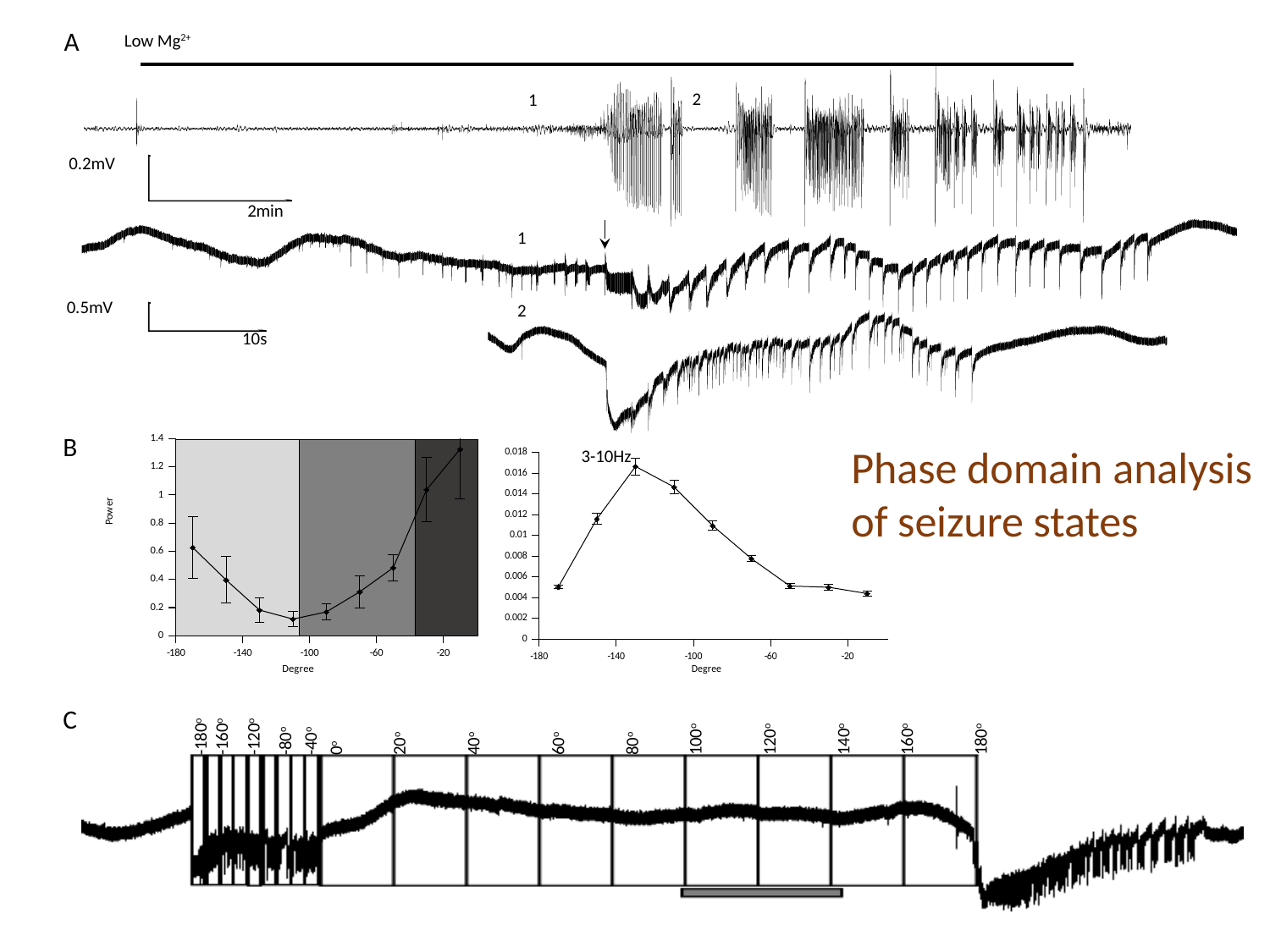
In panel B, on the left (Power) chart, is the lowest point greater or less than 0.2? less In panel B, on the right (3-10Hz) chart, is the highest point greater or less than 0.014? greater In panel B, on the right (3-10Hz) chart, do the values rise or fall from the peak toward the right end of the x axis? fall In panel B, on the left (Power) chart, is the value of the leftmost point greater or less than 0.4? greater In panel B, what kind of chart is the left chart with the y-axis labelled Power? line chart In panel B, on the left (Power) chart, which point is higher: the leftmost point or the rightmost point? the rightmost point In panel B, what label appears at the top of the right chart? 3-10Hz In panel B, how many data points are plotted on the left (Power) chart? 9 In panel B, how many data points are plotted on the right (3-10Hz) chart? 9 In panel B, what is the label on the x axis of the left chart? Degree